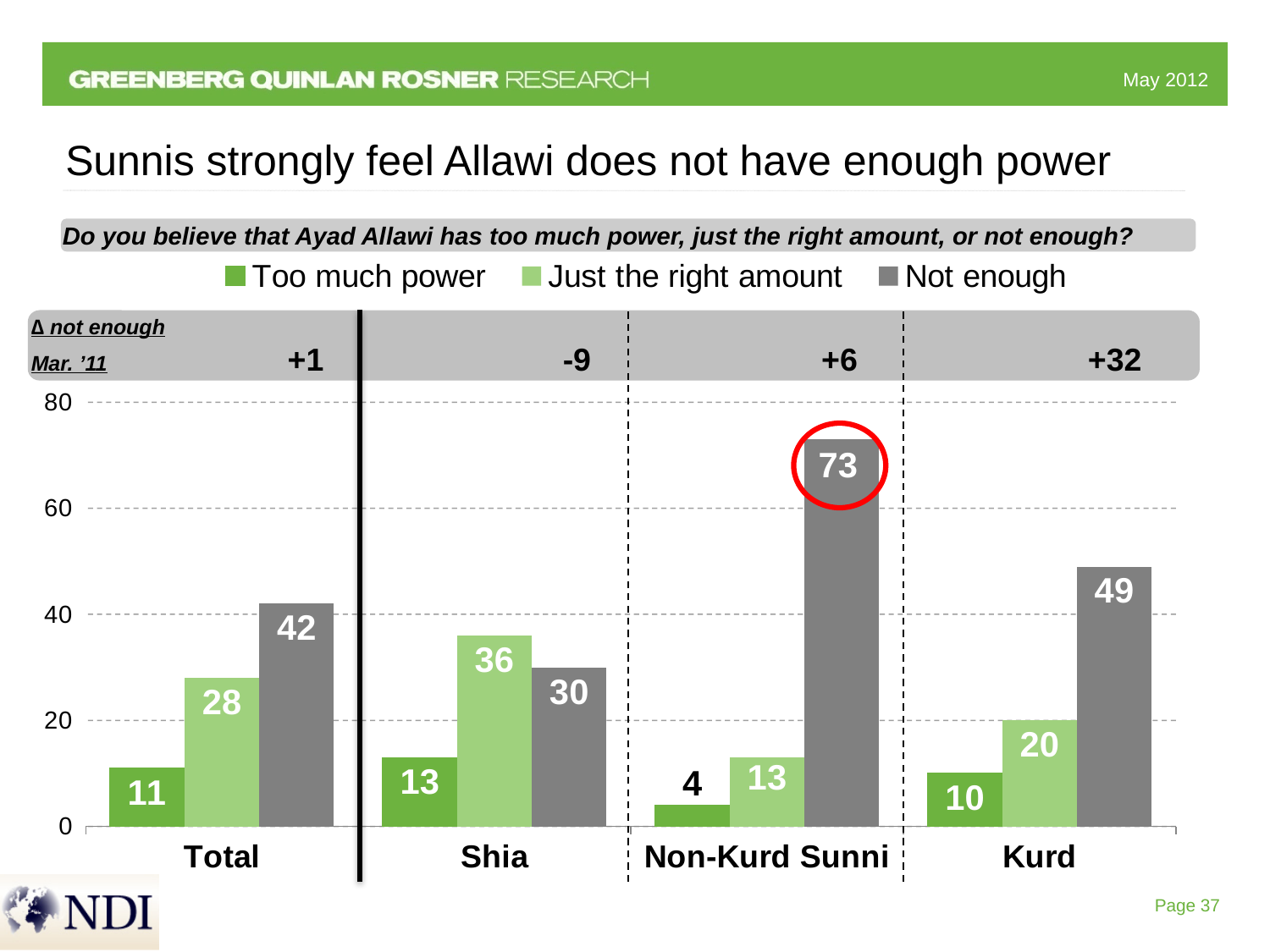
What is the value for 'Too much power' in the Total group? 11 Is the 'Not enough' value for Kurd greater or less than 40? greater What percentage of Non-Kurd Sunnis say Allawi does not have enough power? 73 What is the change in 'not enough' since March 2011 shown for Kurd? +32 What kind of chart is shown on the slide? bar chart Which group has the lowest 'Too much power' value? Non-Kurd Sunni What is the value for 'Just the right amount' among Shia? 36 Which is larger for Shia: 'Just the right amount' or 'Not enough'? Just the right amount Which group has the highest 'Not enough' value? Non-Kurd Sunni How many groups are shown on the x axis? 4 What is the difference between the 'Not enough' values for Non-Kurd Sunni and Kurd? 24 How many series does the legend list? 3